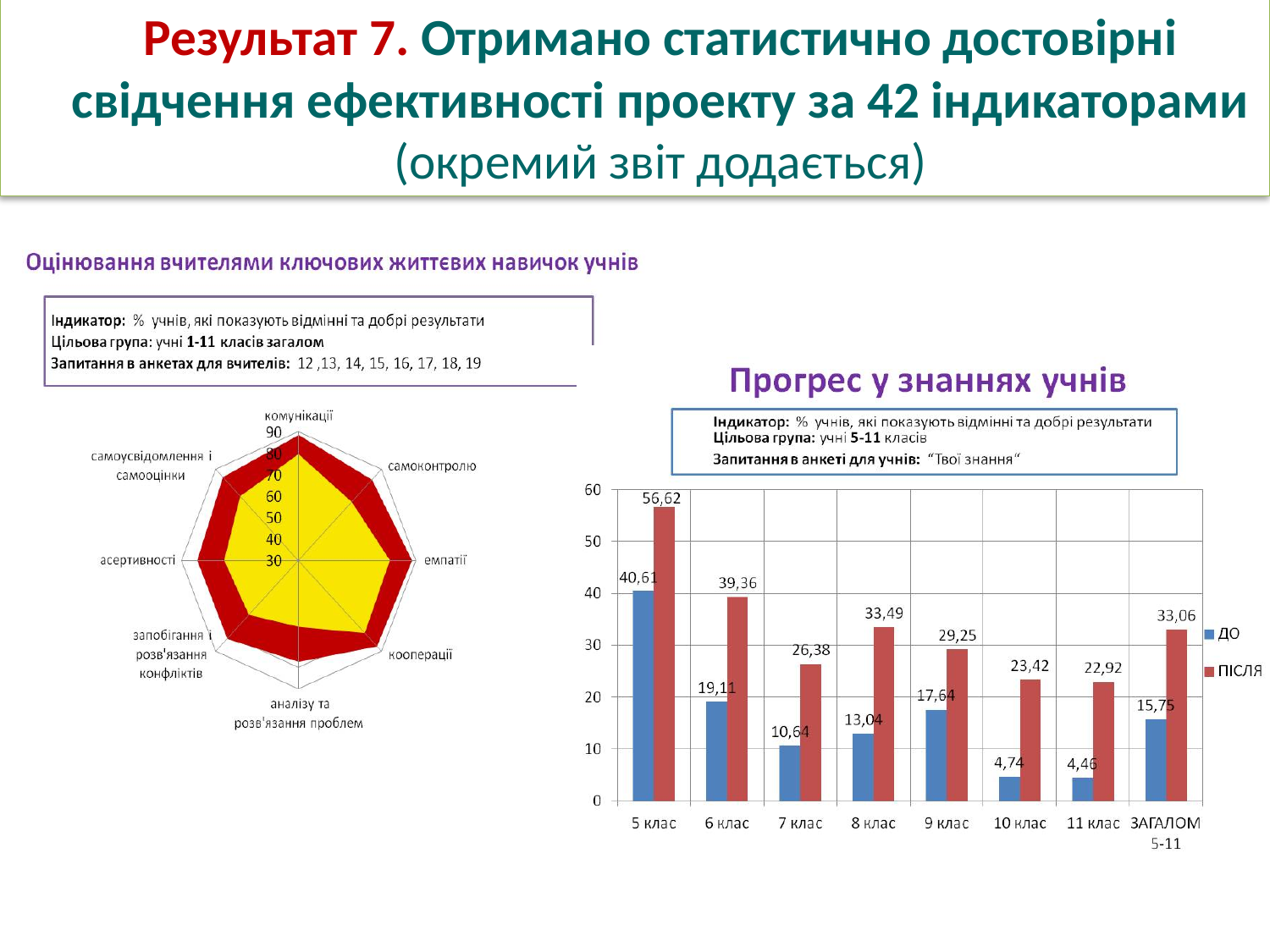
On the bar chart 'Прогрес у знаннях учнів', what colour are the ПІСЛЯ bars? red On the bar chart 'Прогрес у знаннях учнів', which category has the highest ПІСЛЯ value? 5 клас On the bar chart 'Прогрес у знаннях учнів', what is the difference between the ПІСЛЯ and ДО values for 6 клас? 20,25 What kind of chart is the chart on the left side of the slide? radar chart On the bar chart 'Прогрес у знаннях учнів', what is the ПІСЛЯ value for 5 клас? 56,62 On the bar chart 'Прогрес у знаннях учнів', which is larger: the ДО value for 9 клас or the ДО value for 8 клас? 9 клас On the bar chart 'Прогрес у знаннях учнів', what is the ДО value for 10 клас? 4,74 On the bar chart 'Прогрес у знаннях учнів', how many series does the legend list? 2 On the bar chart 'Прогрес у знаннях учнів', how many categories are shown on the x axis? 8 On the bar chart 'Прогрес у знаннях учнів', what is the ПІСЛЯ value for ЗАГАЛОМ 5-11? 33,06 On the bar chart 'Прогрес у знаннях учнів', which class has the lowest ДО value? 11 клас How many categories (axes) does the radar chart on the left have? 8